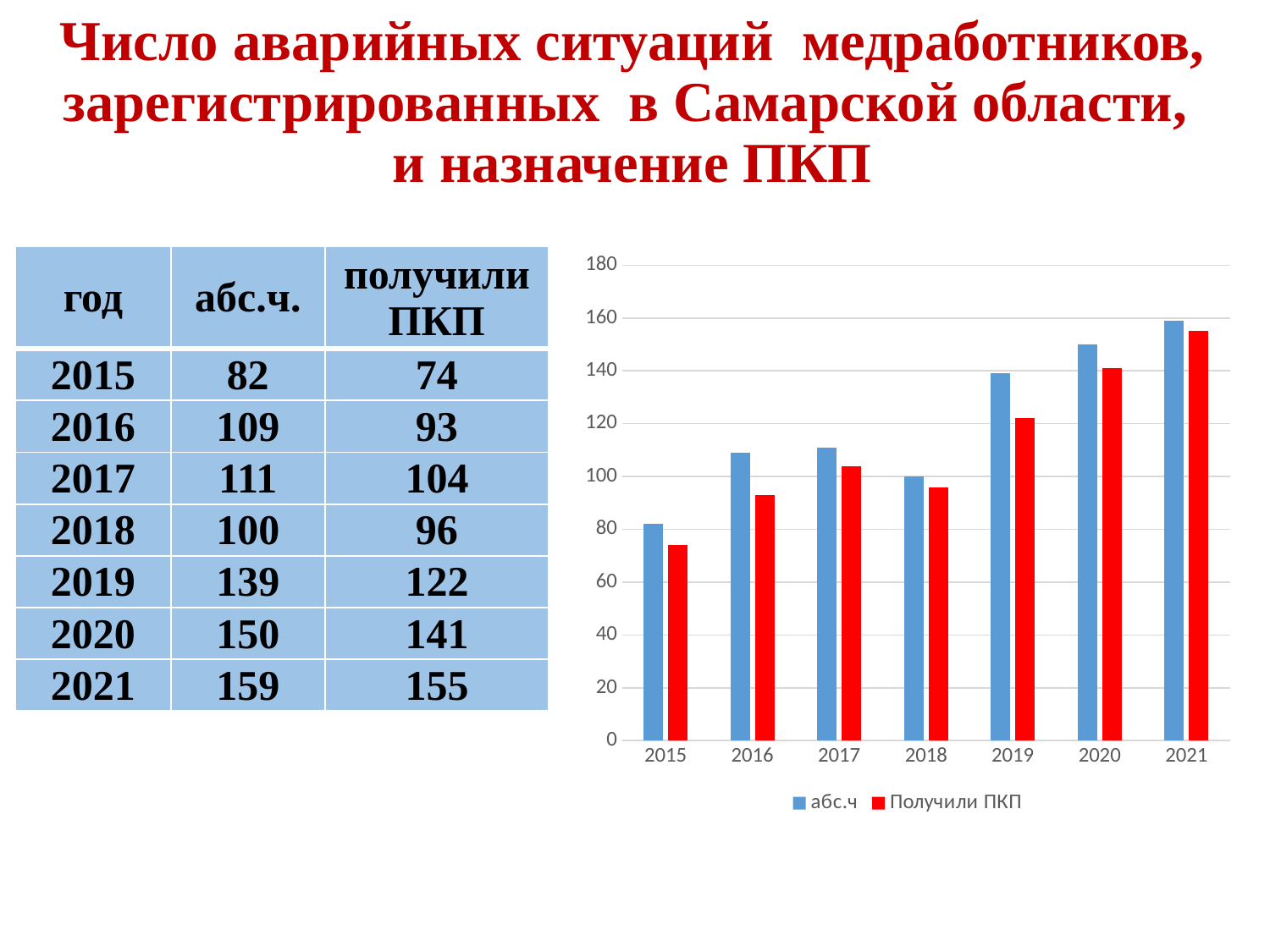
Is the value of Получили ПКП for 2020 greater or less than 120? greater How many series does the chart legend list? 2 What is the value of абс.ч for 2019? 139 Does the value of абс.ч rise or fall from 2019 to 2021? rise What is the value of Получили ПКП for 2017? 104 Which is larger in 2018: абс.ч or Получили ПКП? абс.ч How many years are shown on the x axis of the chart? 7 What is the difference between абс.ч and Получили ПКП in 2016? 16 Which year has the lowest value of Получили ПКП? 2015 What colour are the bars for the Получили ПКП series? red What kind of chart is shown on the slide? bar chart Which year has the highest value of абс.ч? 2021